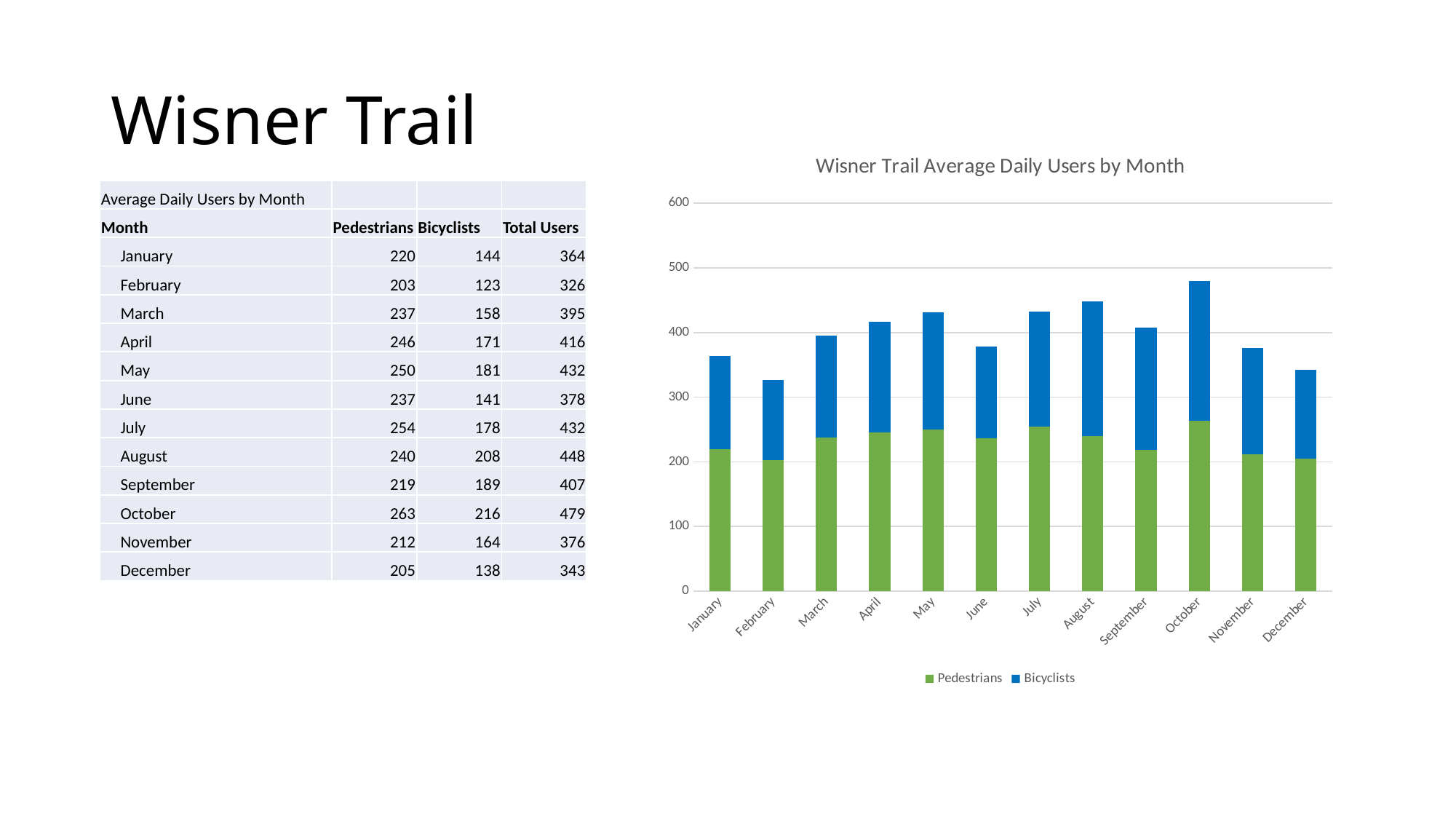
Which month has the highest total bar in the chart? October What is the title of the chart? Wisner Trail Average Daily Users by Month How many series does the chart legend list? 2 Which month has the lowest total bar in the chart? February What is the difference between the Bicyclists values for October and February? 93 What is the Pedestrians value for October? 263 What is the Bicyclists value for August? 208 Which is larger, the Pedestrians value for July or the Pedestrians value for September? July Is the total bar for December greater or less than 400? less How many months are plotted on the x axis of the chart? 12 What is the total of the stacked bar for May? 432 What kind of chart is shown on the slide? Stacked bar chart